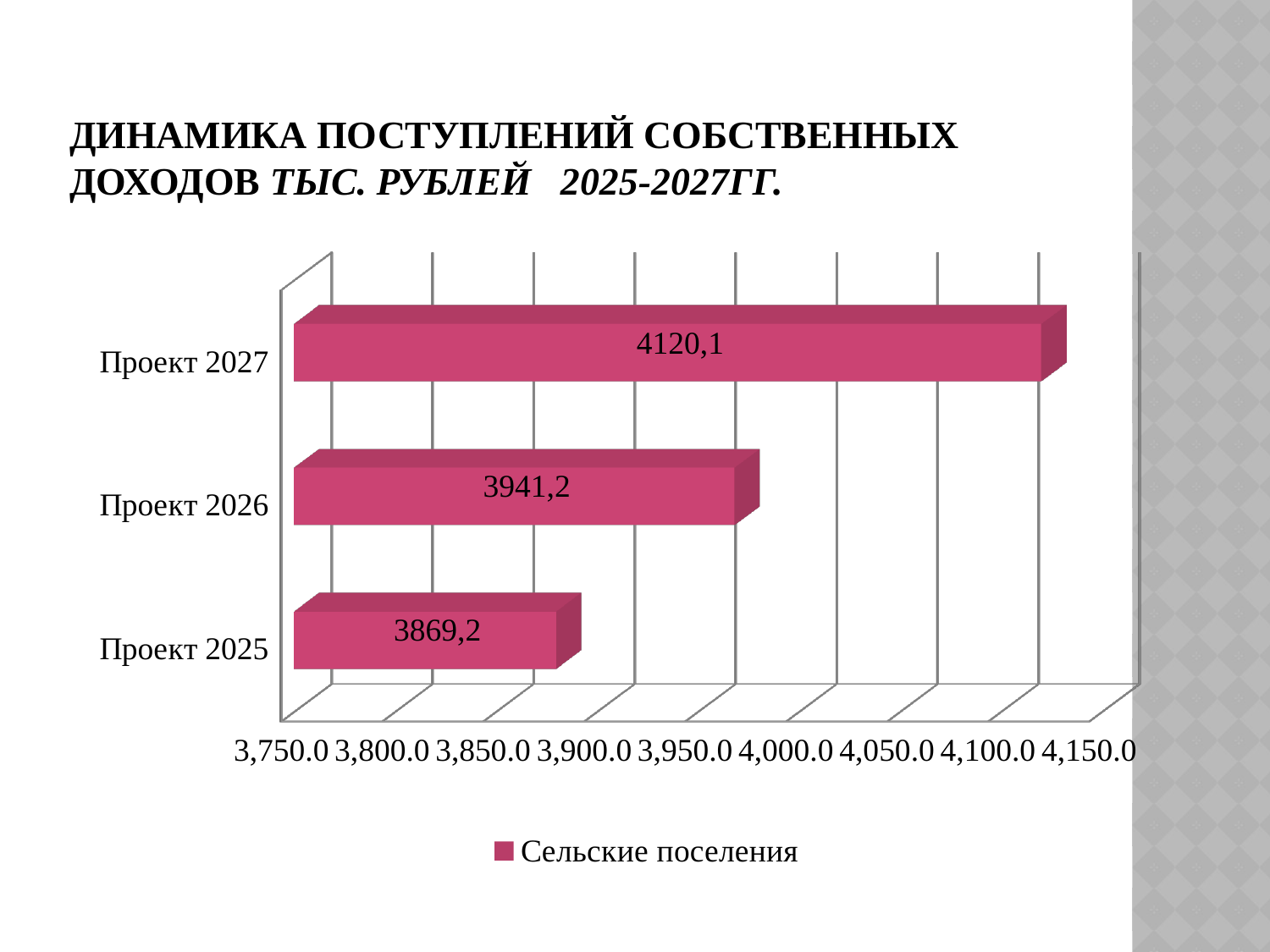
What is the difference between the values for Проект 2027 and Проект 2025? 250,9 Is the value for Проект 2026 greater or less than 4,000.0? less Which category has the highest value? Проект 2027 What kind of chart is shown on the slide? bar chart Which is larger, the value for Проект 2026 or the value for Проект 2027? Проект 2027 What is the value for Проект 2026? 3941,2 How many categories are shown in the chart? 3 What series name does the legend show? Сельские поселения What is the difference between the values for Проект 2026 and Проект 2025? 72,0 What is the value for Проект 2025? 3869,2 What is the value for Проект 2027? 4120,1 Which category has the lowest value? Проект 2025